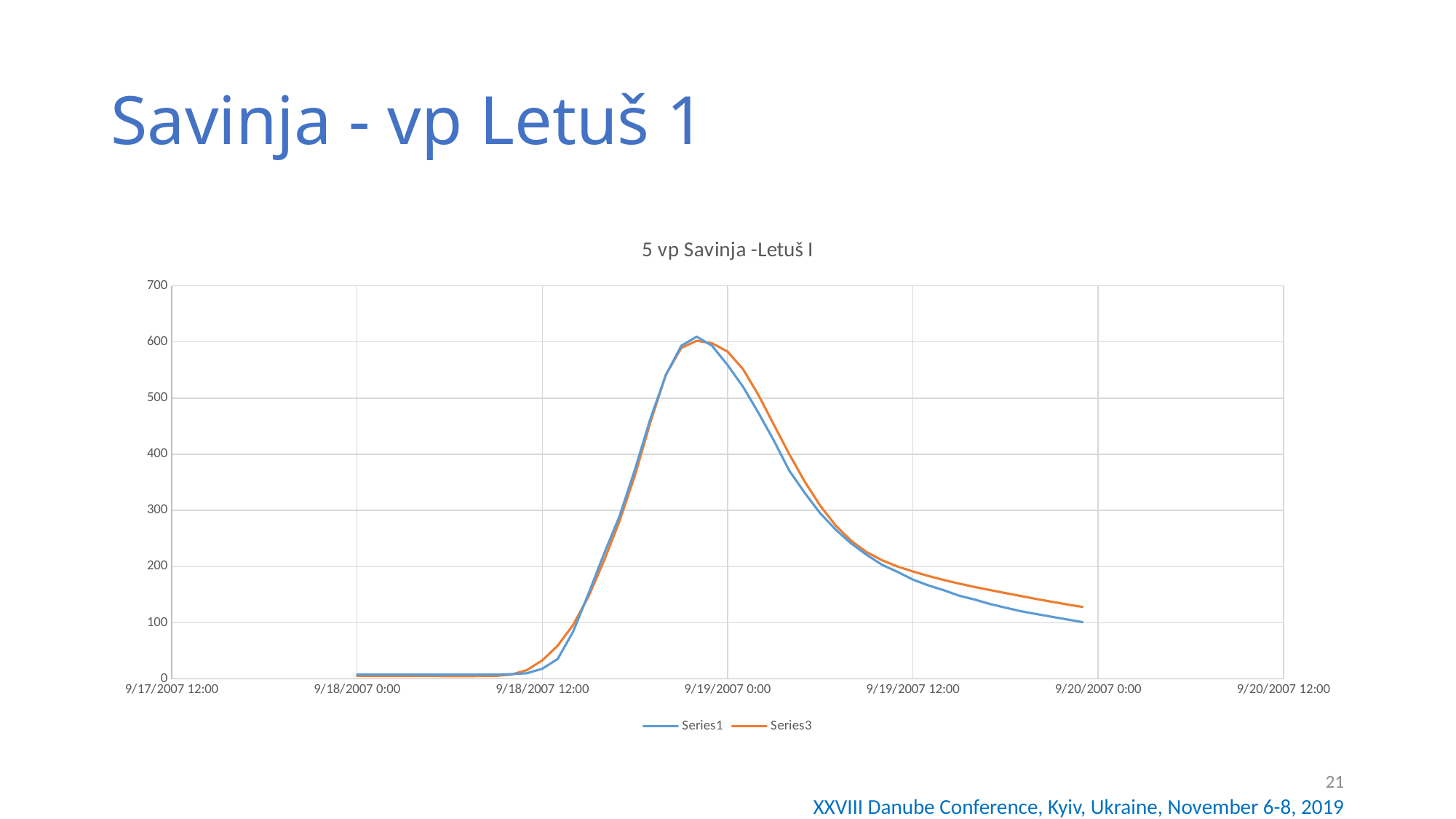
What is the highest value shown on the vertical axis? 700 How many series does the legend list? 2 Is the peak value of Series1 greater or less than 500? greater Which series names are listed in the legend? Series1 and Series3 Is the value of Series1 at 9/18/2007 0:00 greater or less than 100? less Is the value of Series3 at 9/20/2007 0:00 greater or less than 100? greater What kind of chart is shown on the slide? line chart What is the title of the chart? 5 vp Savinja -Letuš I Do the values rise or fall between 9/19/2007 0:00 and 9/20/2007 0:00? fall Do the values rise or fall between 9/18/2007 12:00 and 9/19/2007 0:00? rise Which series has the higher value at 9/20/2007 0:00, Series1 or Series3? Series3